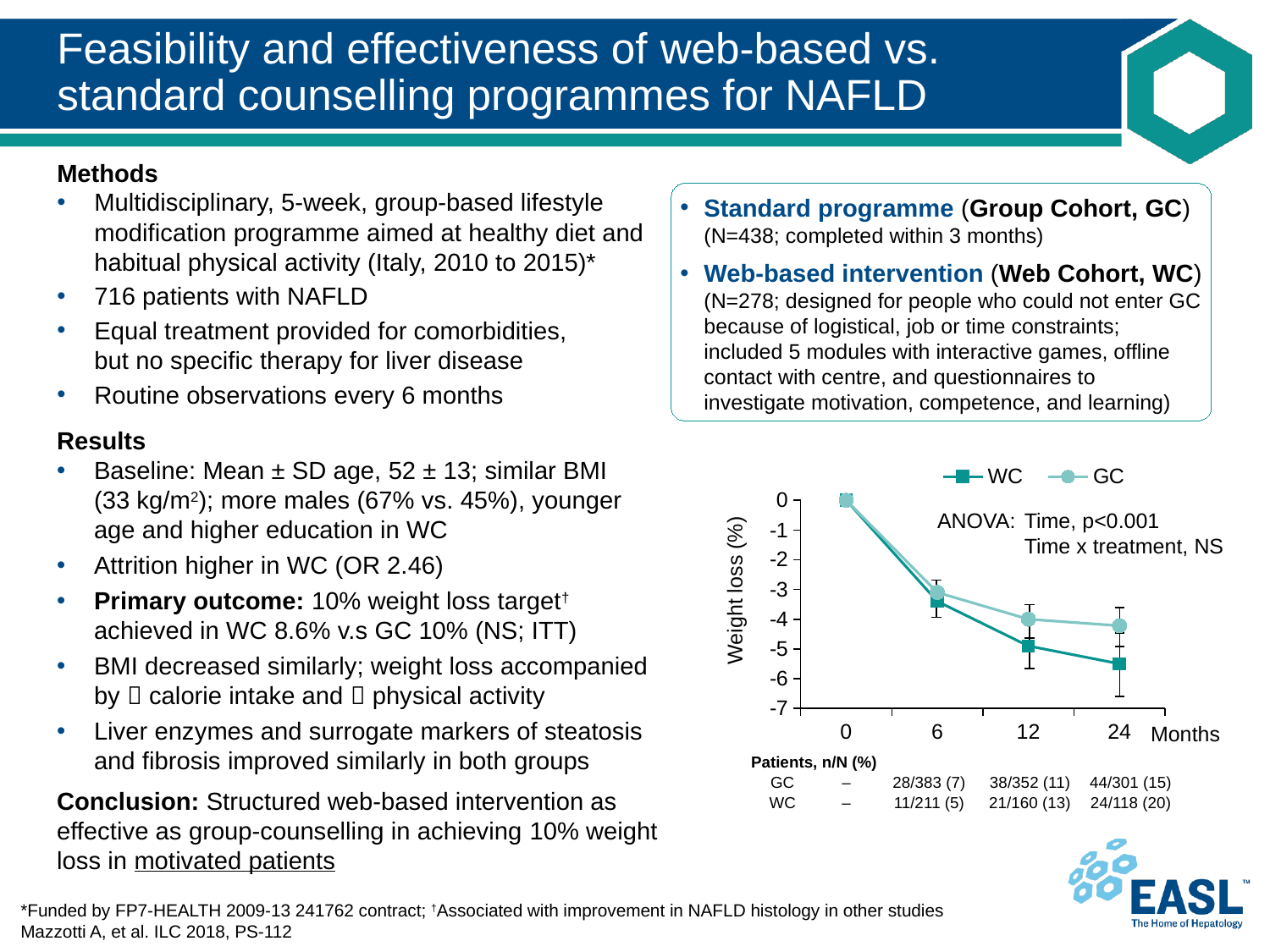
Is the weight loss value for WC at 12 months greater or less than -4? less Is the weight loss value for GC at 6 months greater or less than -4? greater What is the label of the y axis of the chart? Weight loss (%) At 24 months, which series has the lower (more negative) weight loss value, WC or GC? WC Do the weight loss values for GC rise or fall as months increase along the x axis? fall What are the two series named in the chart legend? WC and GC Is the weight loss value for WC at 24 months greater or less than -5? less How many time points are plotted along the x axis of the chart? 4 What is the weight loss value for WC at 0 months? 0 What kind of chart is shown on the slide? line chart How many series does the chart legend list? 2